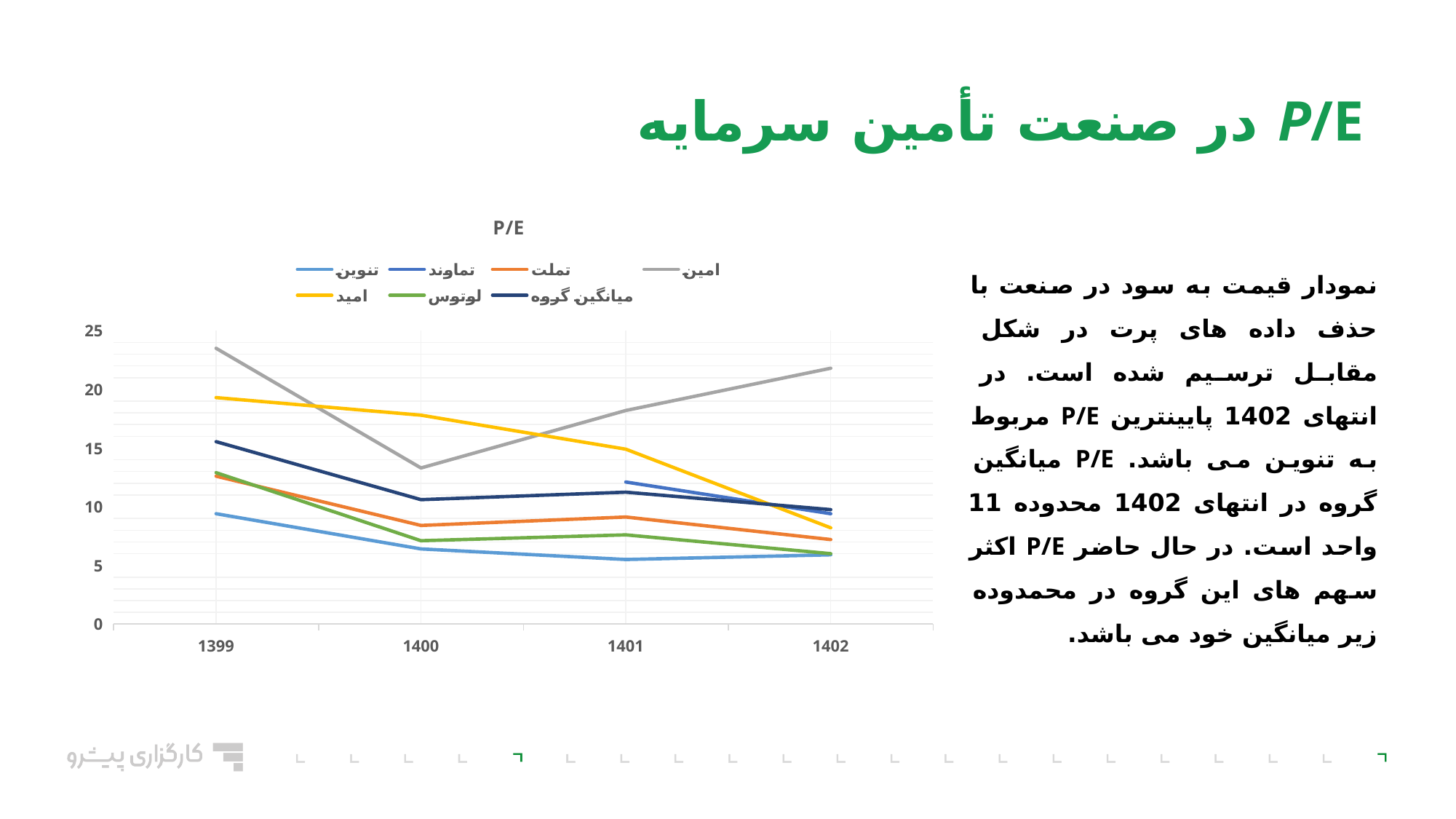
Is the value for امید in 1402 greater or less than 10? less Is the value for امین in 1399 greater or less than 20? greater Is the value for تنوین in 1400 greater or less than 10? less Which series has the highest value in 1399? امین What kind of chart is shown on the slide? line chart Which series has the lowest value in 1401? تنوین In 1400, which is larger: the value for امید or the value for امین? امید How many series does the legend of the P/E chart list? 7 Does the value for امید rise or fall from 1399 to 1402? fall How many years are shown on the x axis of the P/E chart? 4 What is the title of the chart? P/E